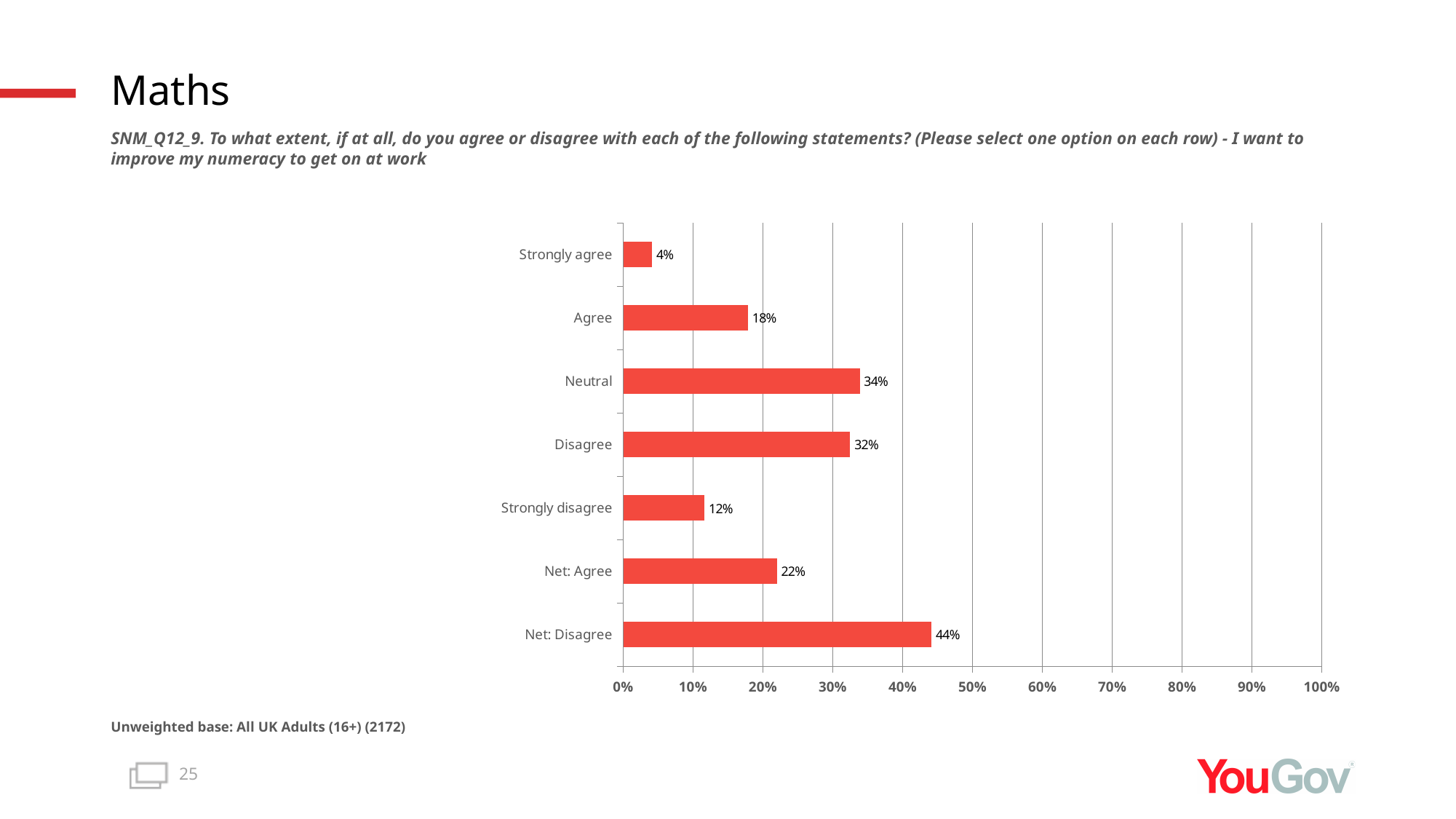
What is the value shown for 'Strongly agree'? 4% Which category has the highest value? Net: Disagree What is the value shown for 'Strongly disagree'? 12% Is the value for 'Net: Disagree' greater or less than 40%? greater What percentage of respondents selected 'Neutral'? 34% Which is larger, the value for 'Disagree' or the value for 'Agree'? Disagree What kind of chart is shown on the slide? Bar chart What is the difference between 'Net: Disagree' and 'Net: Agree'? 22% Which category has the lowest value? Strongly agree What is the value shown for 'Net: Disagree'? 44% What is the difference between 'Agree' and 'Strongly agree'? 14% How many categories are shown on the chart? 7